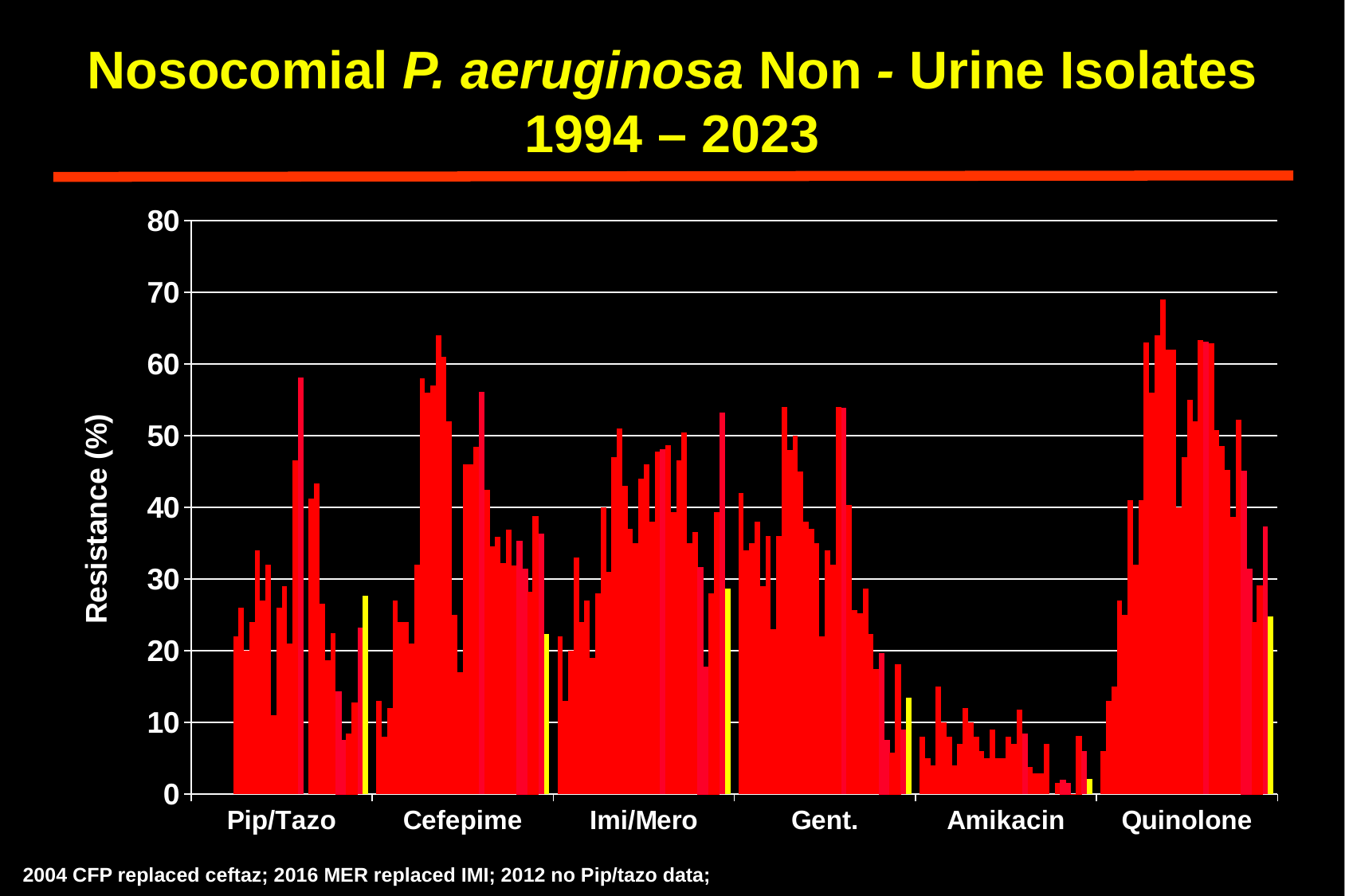
Is the tallest bar in the Amikacin group greater or less than 20? less Which antibiotic group has the lowest resistance values overall? Amikacin Is the yellow (final-year) bar in the Gent. group greater or less than 10? greater Is the tallest bar in the Quinolone group greater or less than 60? greater What kind of chart is shown on the slide? bar chart Which antibiotic group contains the tallest bar on the chart? Quinolone What is the title of the chart? Nosocomial P. aeruginosa Non - Urine Isolates 1994 – 2023 Which group has the higher peak bar, Cefepime or Pip/Tazo? Cefepime How many antibiotic groups are labelled along the x axis? 6 What is the label on the y axis? Resistance (%)